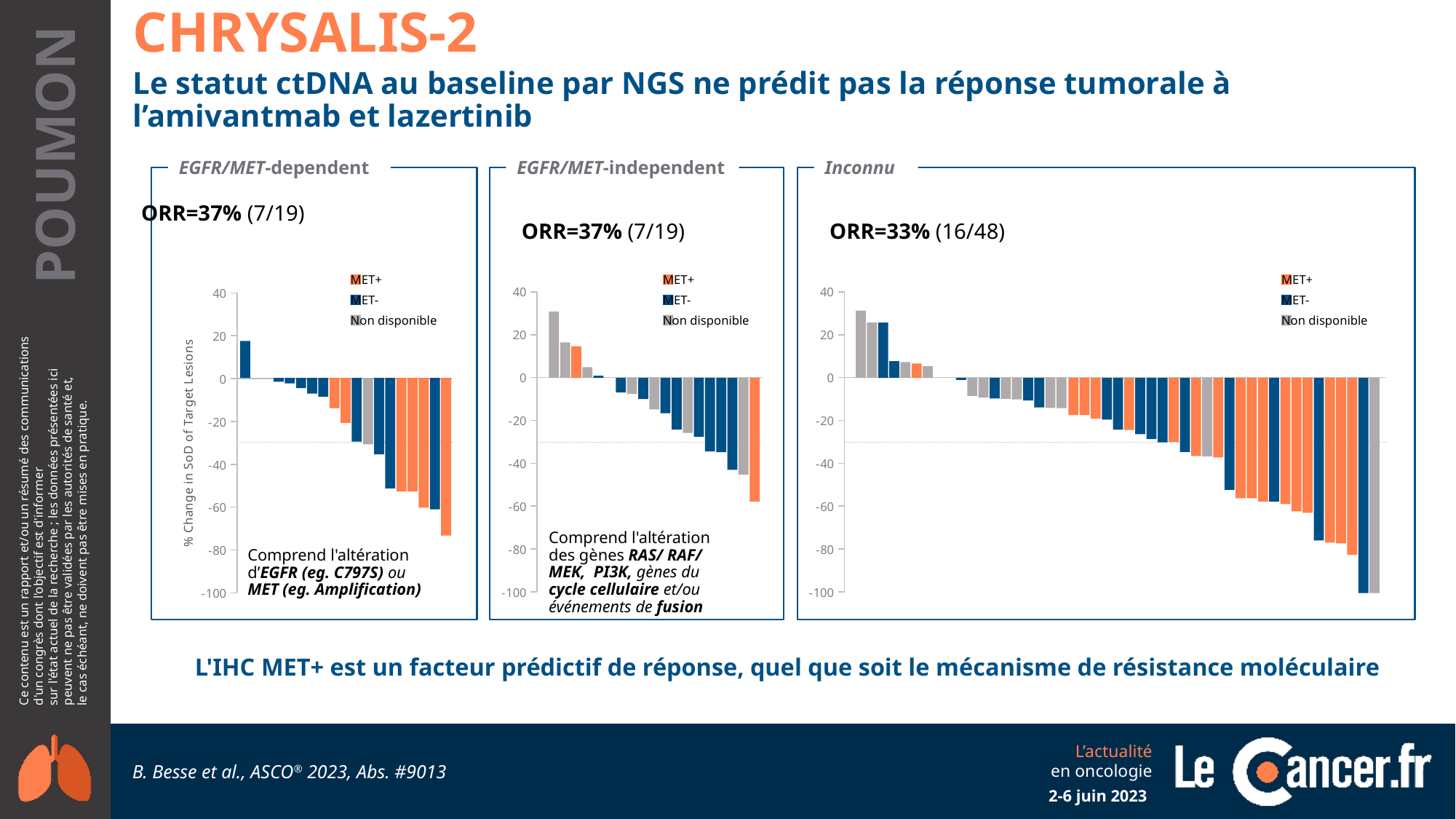
What is the ORR reported for the EGFR/MET-dependent group? 37% (7/19) How many series does the legend of the Inconnu chart list? 3 What kind of chart is shown in the EGFR/MET-dependent panel? bar chart Which of the three groups has the lowest ORR? Inconnu Is the ORR for the EGFR/MET-dependent group larger or smaller than the ORR for the Inconnu group? larger What is the ORR reported for the Inconnu group? 33% (16/48) What is the y-axis label of the EGFR/MET-dependent chart? % Change in SoD of Target Lesions What are the three legend entries in the EGFR/MET-independent chart? MET+, MET-, Non disponible In the EGFR/MET-independent chart, is the value of the highest bar greater or less than 20? greater In the EGFR/MET-independent chart, is the value of the lowest bar greater or less than -40? less In the EGFR/MET-dependent chart, is the value of the lowest bar greater or less than -60? less